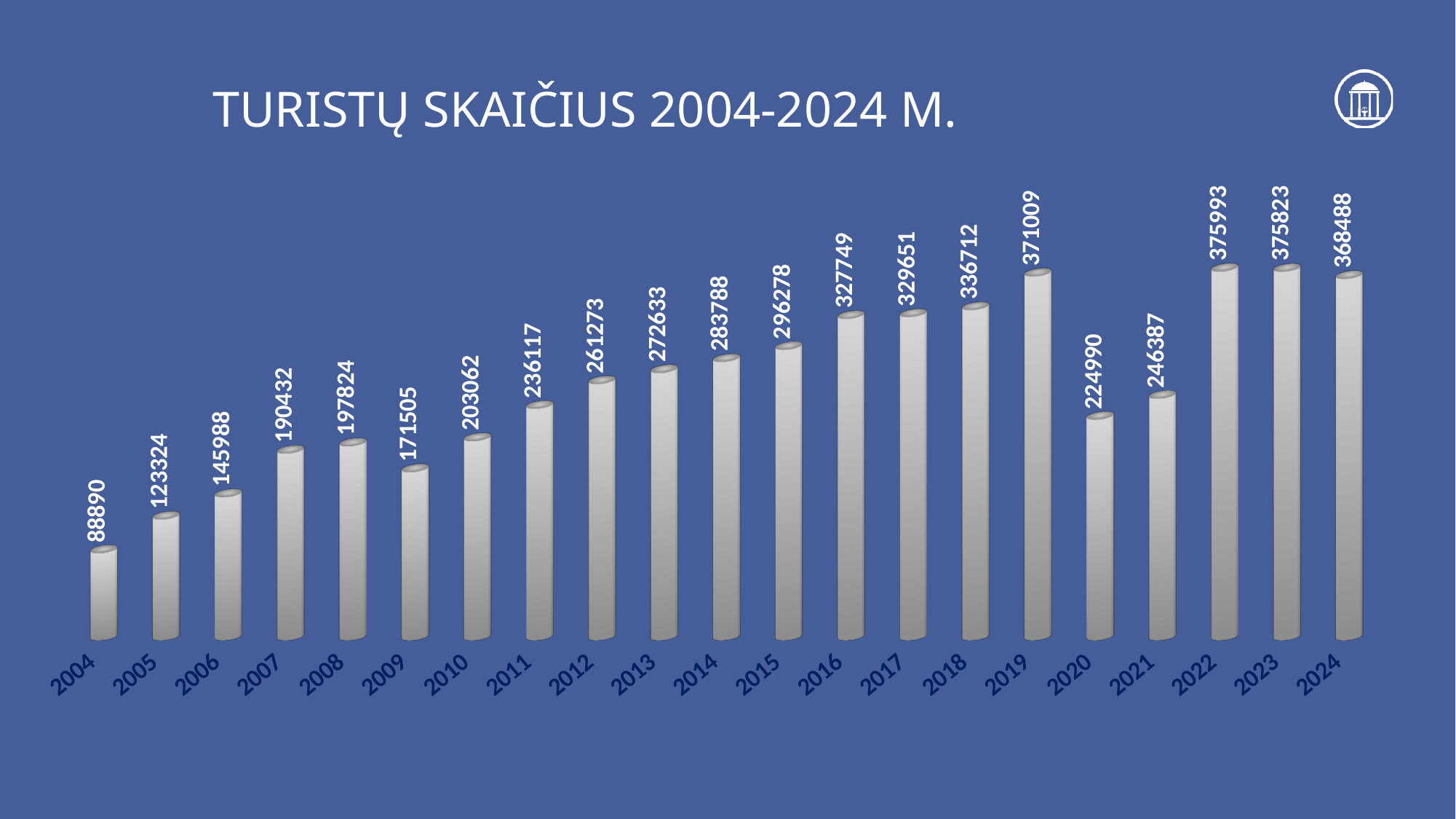
What kind of chart is this? bar chart Which year has the lowest value? 2004 Which year has the highest value? 2022 What value is shown for 2019? 371009 How many years are shown on the x axis? 21 What is the value for 2020? 224990 What is the difference between the values for 2019 and 2020? 146019 What is the number of tourists shown for 2004? 88890 What value is shown for 2024? 368488 What is the difference between the values for 2024 and 2004? 279598 What is the title of the chart? TURISTŲ SKAIČIUS 2004-2024 M. Which is larger, the value for 2009 or the value for 2010? 2010